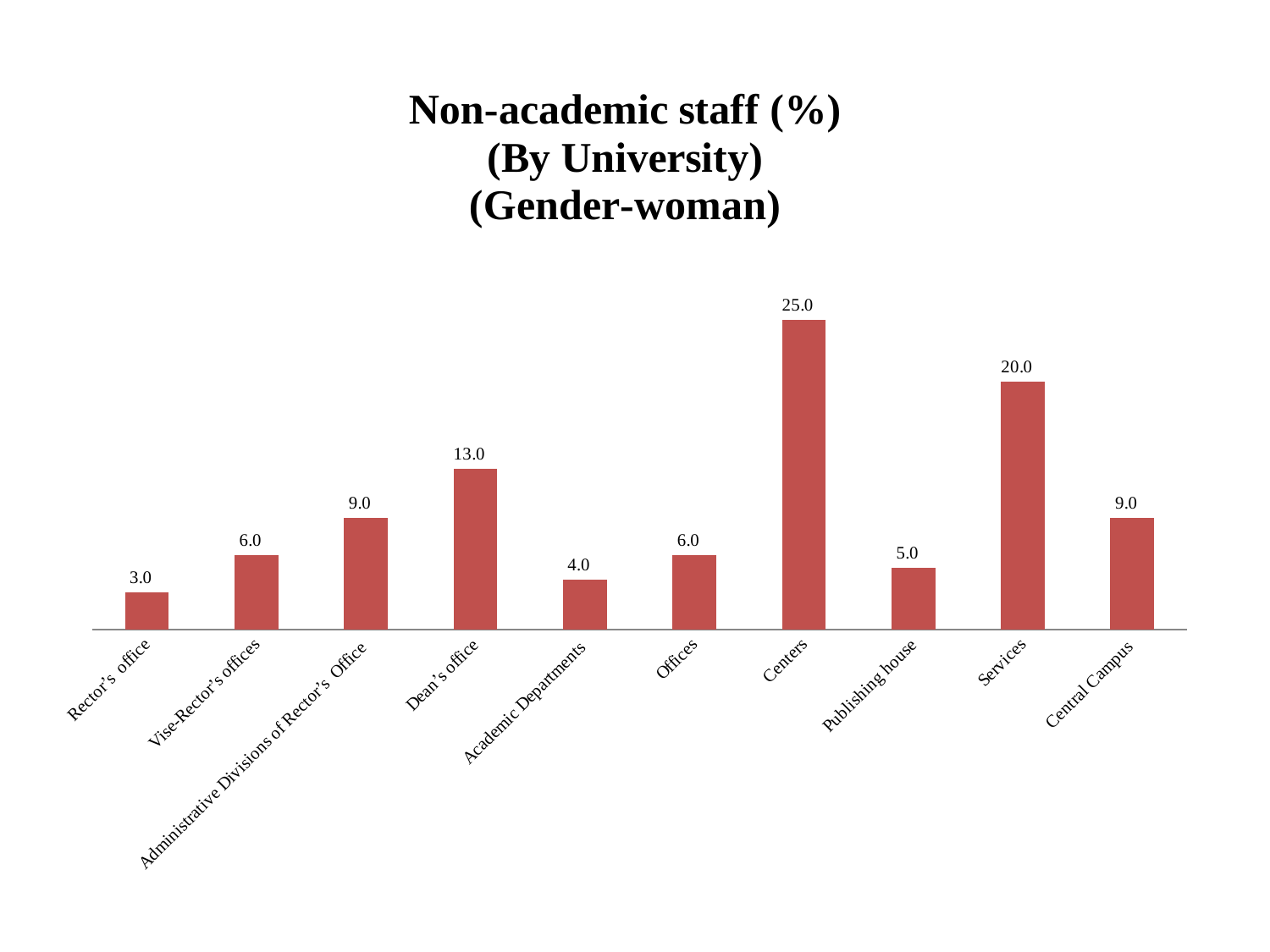
What is the difference between the values for Centers and Services? 5.0 Which category has the highest value? Centers How many categories are shown on the x axis? 10 Which is larger, the value for Services or the value for Central Campus? Services What is the value for Centers? 25.0 Which category has the lowest value? Rector's office What is the title of the chart? Non-academic staff (%) (By University) (Gender-woman) What is the value for Administrative Divisions of Rector's Office? 9.0 What is the value for Publishing house? 5.0 What is the difference between the values for Dean's office and Academic Departments? 9.0 What is the value for Dean's office? 13.0 What kind of chart is this? Bar chart